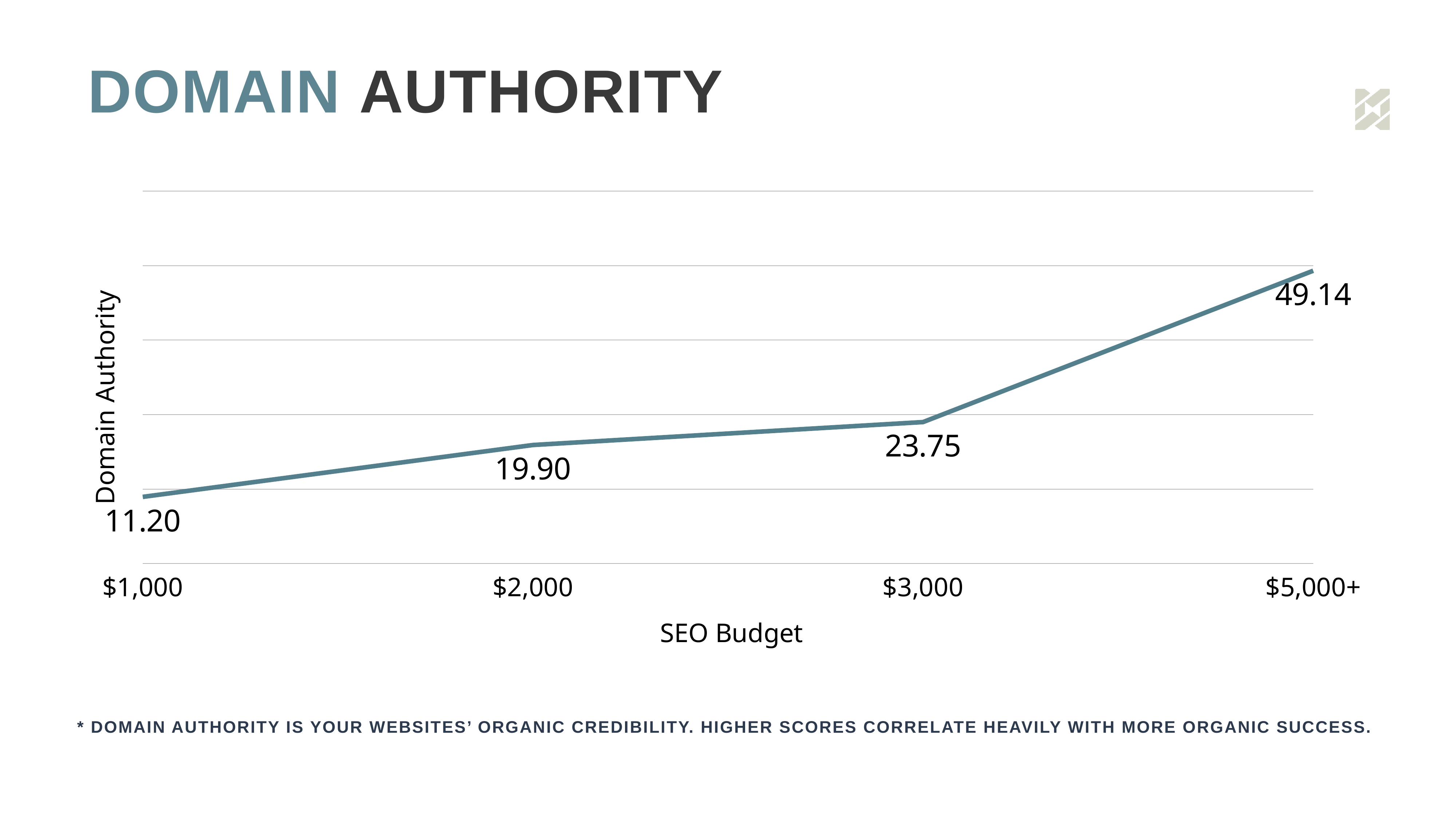
What is the Domain Authority value for an SEO Budget of $3,000? 23.75 What is the difference in Domain Authority between the $5,000+ and $3,000 SEO Budget levels? 25.39 What kind of chart is shown on the slide? Line chart What is the difference in Domain Authority between the $2,000 and $1,000 SEO Budget levels? 8.70 Which SEO Budget level has the lowest Domain Authority? $1,000 Which has a higher Domain Authority: the $2,000 or the $3,000 SEO Budget level? $3,000 What is the Domain Authority value for an SEO Budget of $5,000+? 49.14 Which SEO Budget level has the highest Domain Authority? $5,000+ What is the Domain Authority value for an SEO Budget of $1,000? 11.20 Does Domain Authority rise or fall as the SEO Budget increases along the x axis? Rises What is the Domain Authority value for an SEO Budget of $2,000? 19.90 How many SEO Budget levels are plotted on the chart? 4